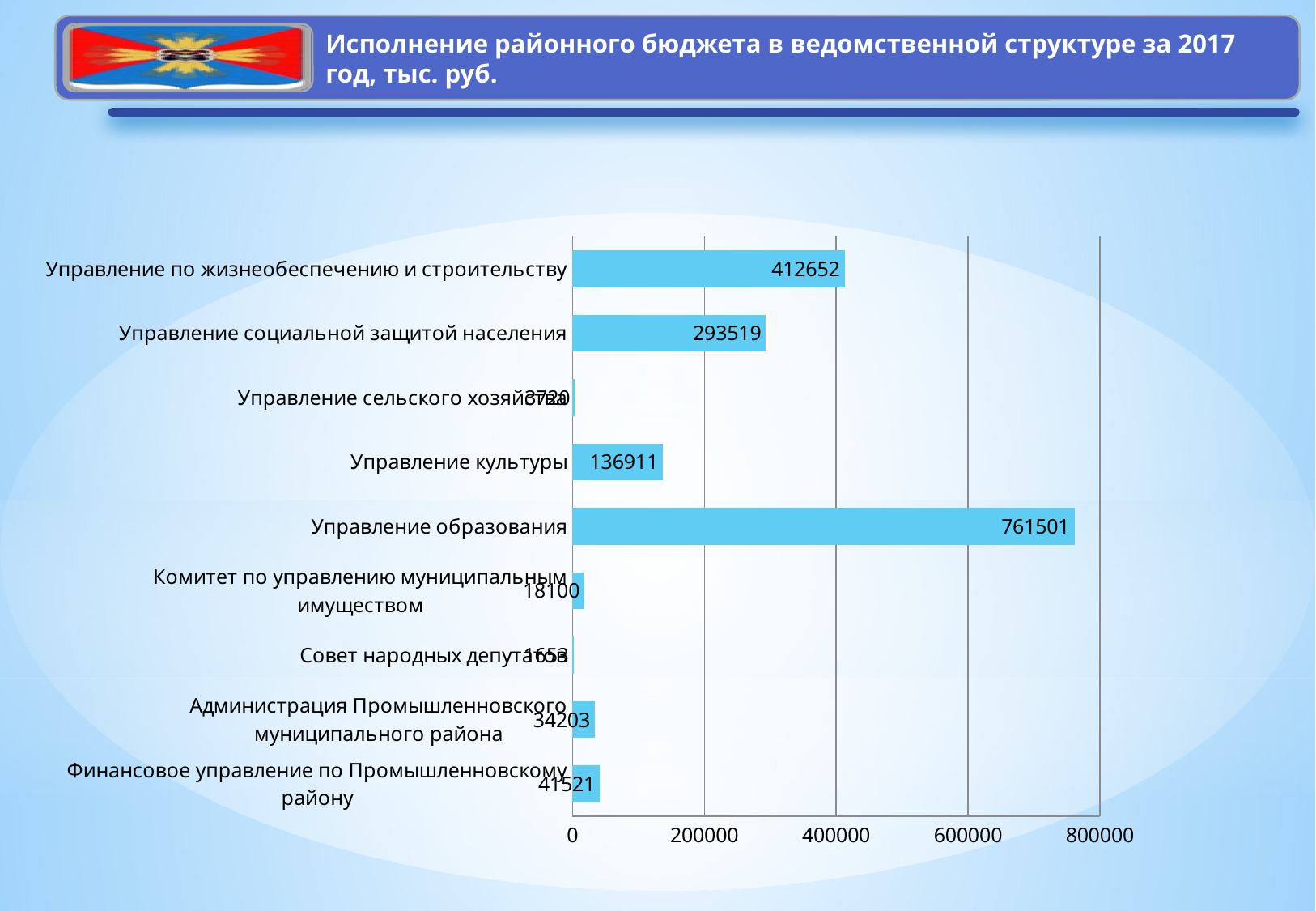
What is the value for Управление социальной защитой населения? 293519 Is the value for Управление образования greater or less than 600000? greater What is the value for Администрация Промышленновского муниципального района? 34203 What is the value for Управление по жизнеобеспечению и строительству? 412652 Which is larger, the value for Управление культуры or the value for Управление социальной защитой населения? Управление социальной защитой населения What is the difference between the values for Управление образования and Управление по жизнеобеспечению и строительству? 348849 What is the value for Управление образования? 761501 What is the difference between the values for Управление социальной защитой населения and Управление культуры? 156608 What kind of chart is shown on the slide? bar chart What is the value for Управление культуры? 136911 Which category has the highest value? Управление образования How many categories are shown in the chart? 9